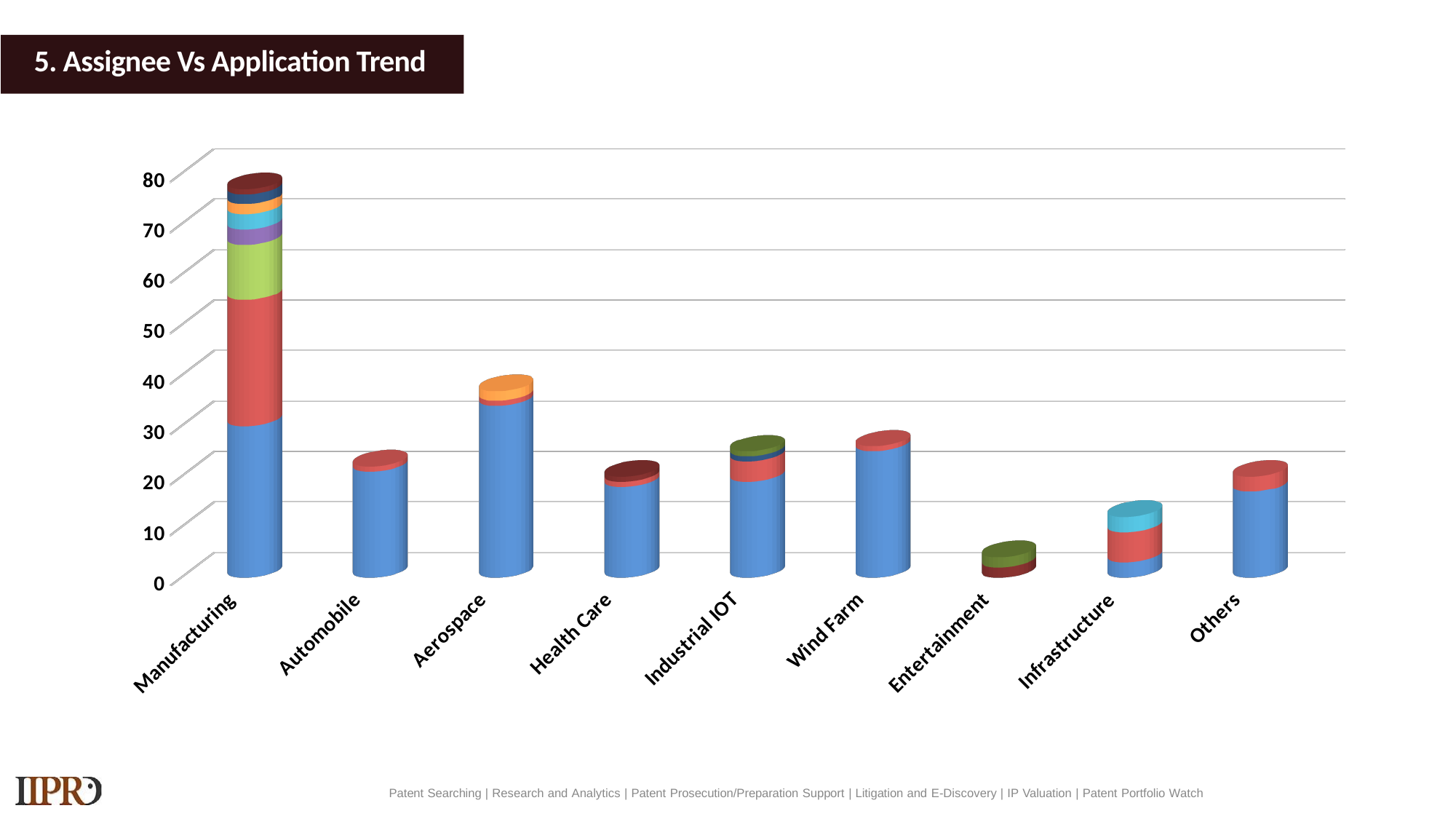
What kind of chart is shown on the slide? Stacked bar chart Is the total value for Aerospace greater or less than 30? greater Which category has the shortest stacked bar? Entertainment What is the title of the slide containing the chart? 5. Assignee Vs Application Trend Is the total value for Wind Farm greater or less than 30? less How many application categories are shown on the x axis? 9 Is the total value for Manufacturing greater or less than 70? greater Which has the larger stacked bar, Wind Farm or Entertainment? Wind Farm Which category has the tallest stacked bar? Manufacturing Which has the larger stacked bar, Aerospace or Automobile? Aerospace